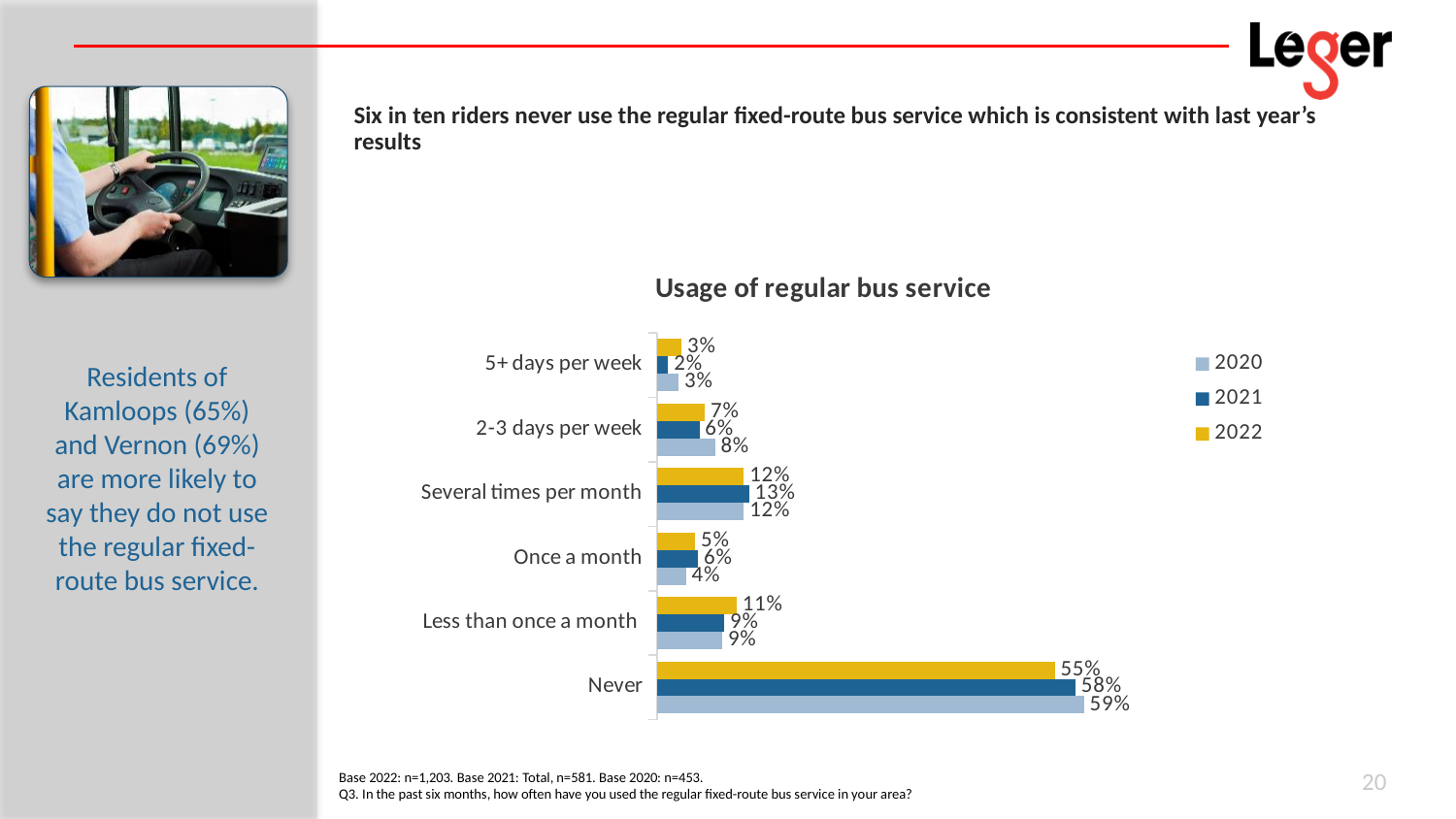
What is the 2021 value for "Several times per month"? 13% What type of chart is shown on the slide? Bar chart Which category has the lowest value for 2021? 5+ days per week What is the 2022 value for "Never"? 55% What is the title of the chart? Usage of regular bus service What is the 2022 value for "Less than once a month"? 11% What is the difference between the 2020 and 2022 values for "Never"? 4% How many categories are shown on the chart? 6 How many series does the legend list? 3 Which is larger for "2-3 days per week": the 2020 value or the 2021 value? 2020 What is the 2020 value for "Never"? 59% Which category has the highest value for 2022? Never